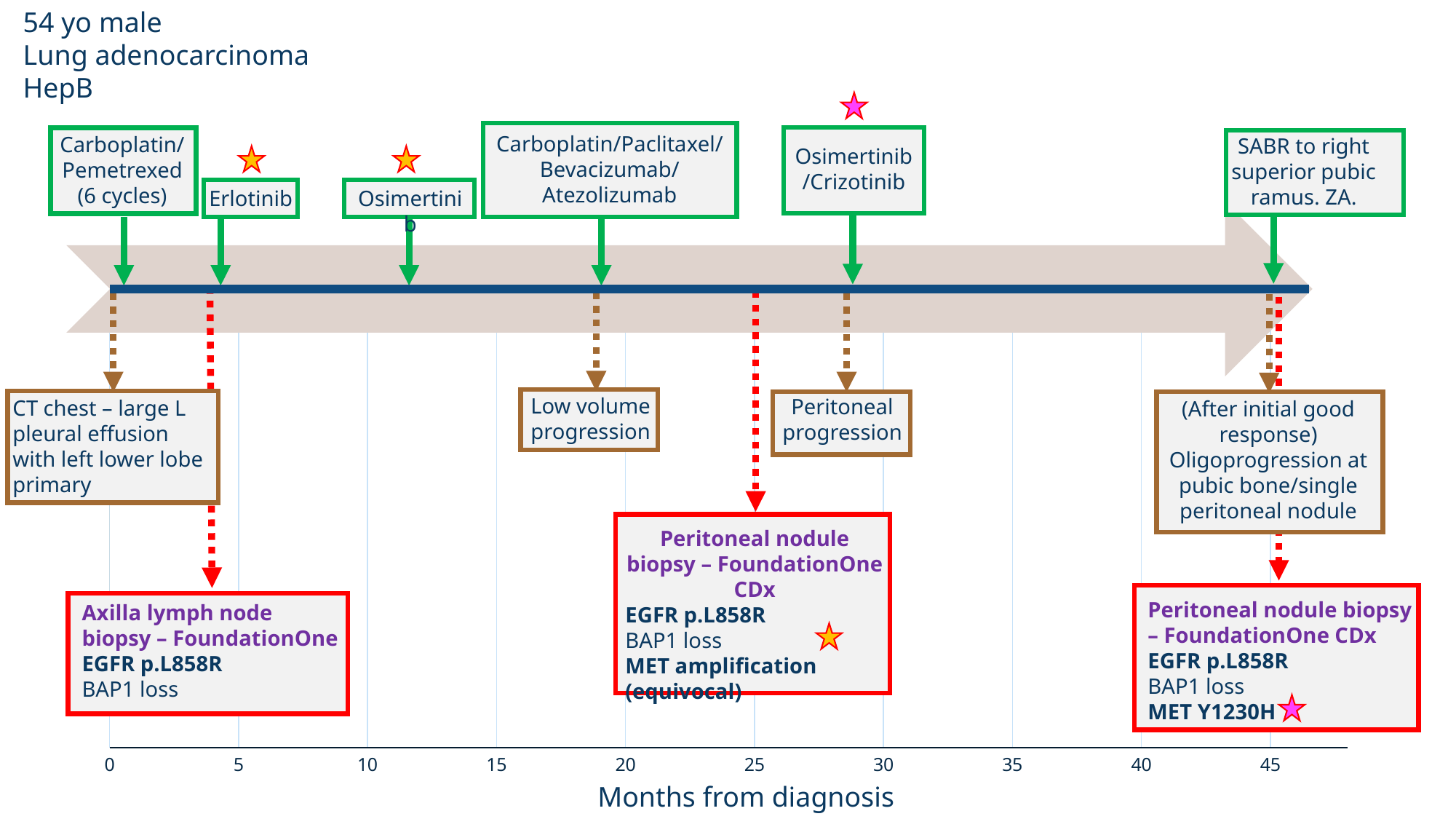
Is the start of Osimertinib on the timeline greater or less than 10 months from diagnosis? greater Is the 'Low volume progression' event on the timeline greater or less than 20 months from diagnosis? less Is the start of Carboplatin/Paclitaxel/Bevacizumab/Atezolizumab on the timeline greater or less than 20 months from diagnosis? less What is the title of the horizontal axis of the timeline? Months from diagnosis What is the highest tick value labelled on the horizontal axis of the timeline? 45 How many red-bordered biopsy result boxes are shown below the timeline? 3 What kind of chart is shown on the slide? Timeline Which treatment is the first one shown on the timeline? Carboplatin/Pemetrexed (6 cycles) Which occurs later on the timeline: the start of Erlotinib or the start of Osimertinib? Osimertinib How many green treatment boxes are placed above the timeline? 6